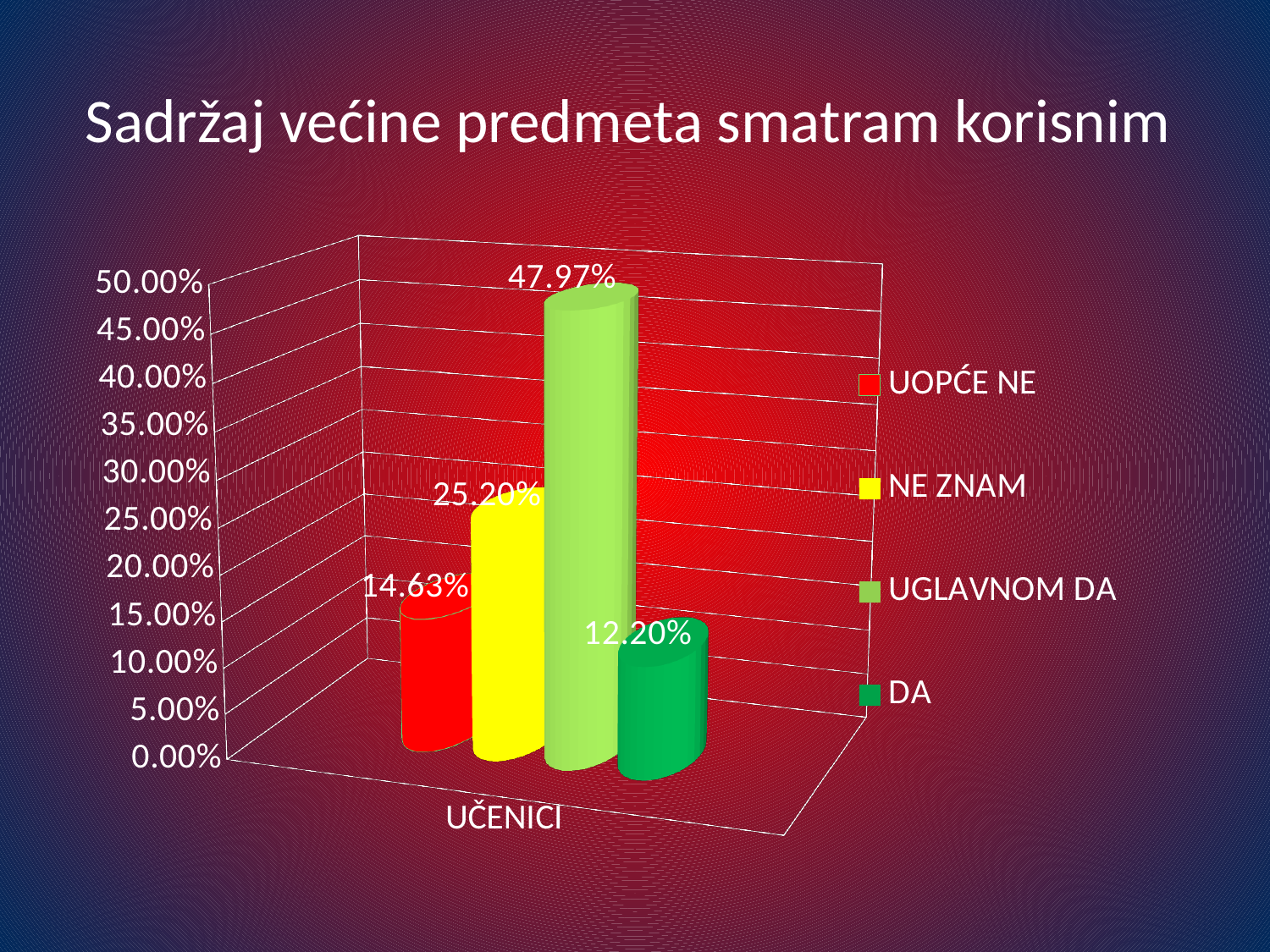
Which series has the highest value? UGLAVNOM DA What is the value for DA? 12.20% Which series has the lowest value? DA What kind of chart is shown on the slide? bar chart What is the value for UOPĆE NE? 14.63% What is the value for NE ZNAM? 25.20% What is the value for UGLAVNOM DA? 47.97% What is the difference between the values for UGLAVNOM DA and NE ZNAM? 22.77% Is the value for NE ZNAM greater or less than 30.00%? less How many series does the legend list? 4 Which is larger, the value for UOPĆE NE or the value for DA? UOPĆE NE What is the title of the chart? Sadržaj većine predmeta smatram korisnim